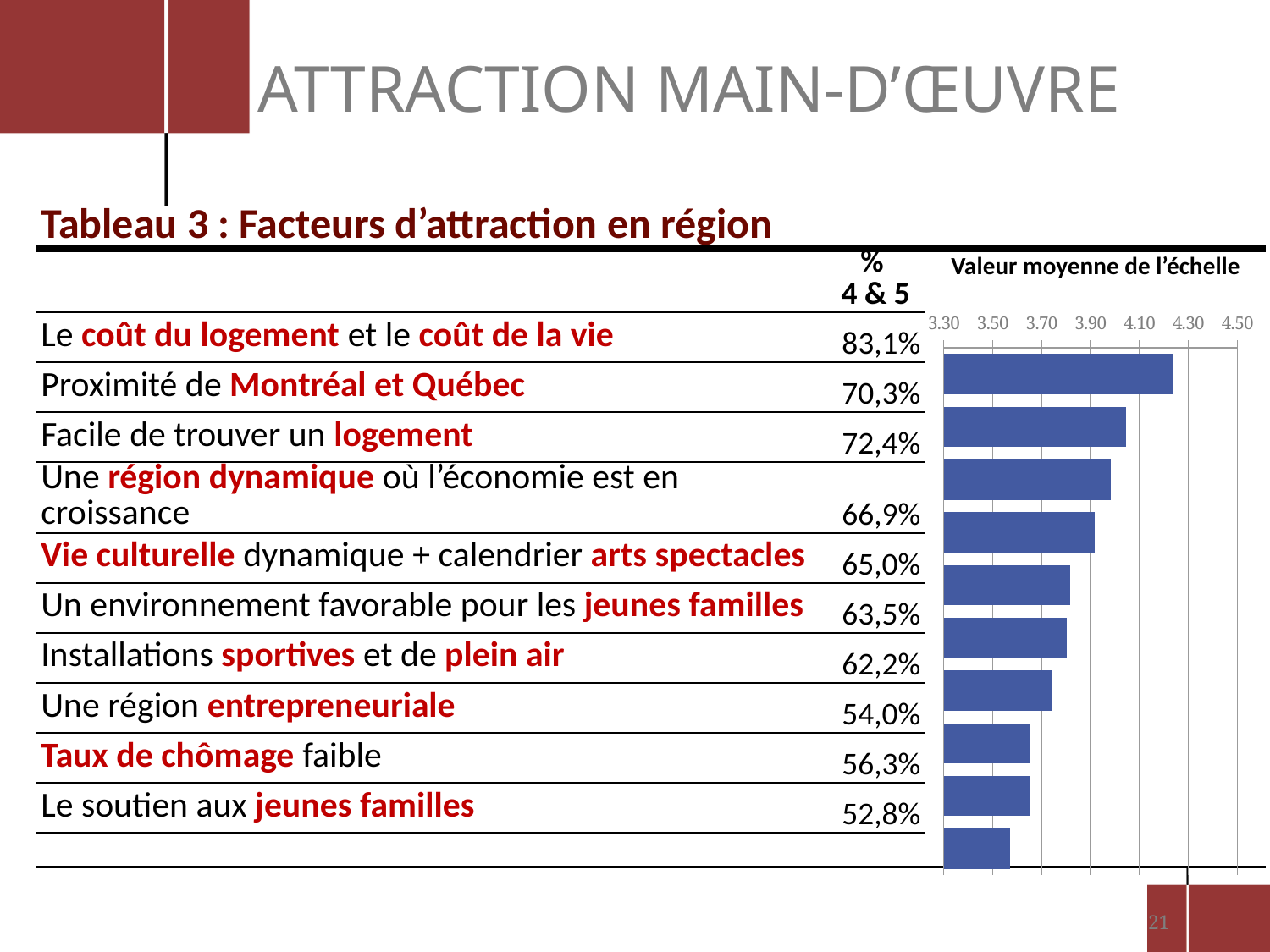
Is the bar for 'Vie culturelle dynamique + calendrier arts spectacles' greater or less than 3.70? greater Is the bar for 'Le soutien aux jeunes familles' greater or less than 3.70? less What is the title of the chart on the right of the table? Valeur moyenne de l'échelle Is the bar for 'Le coût du logement et le coût de la vie' greater or less than 4.10? greater What are the lowest and highest tick values shown on the chart's axis? 3.30 and 4.50 Do the bar lengths in the chart generally rise or fall from the top row to the bottom row? fall Which factor has the longest bar in the chart 'Valeur moyenne de l'échelle'? Le coût du logement et le coût de la vie What kind of chart is shown next to the table on the slide? bar chart How many bars does the chart 'Valeur moyenne de l'échelle' contain? 10 Which bar is longer: 'Le coût du logement et le coût de la vie' or 'Proximité de Montréal et Québec'? Le coût du logement et le coût de la vie Which factor has the shortest bar in the chart 'Valeur moyenne de l'échelle'? Le soutien aux jeunes familles